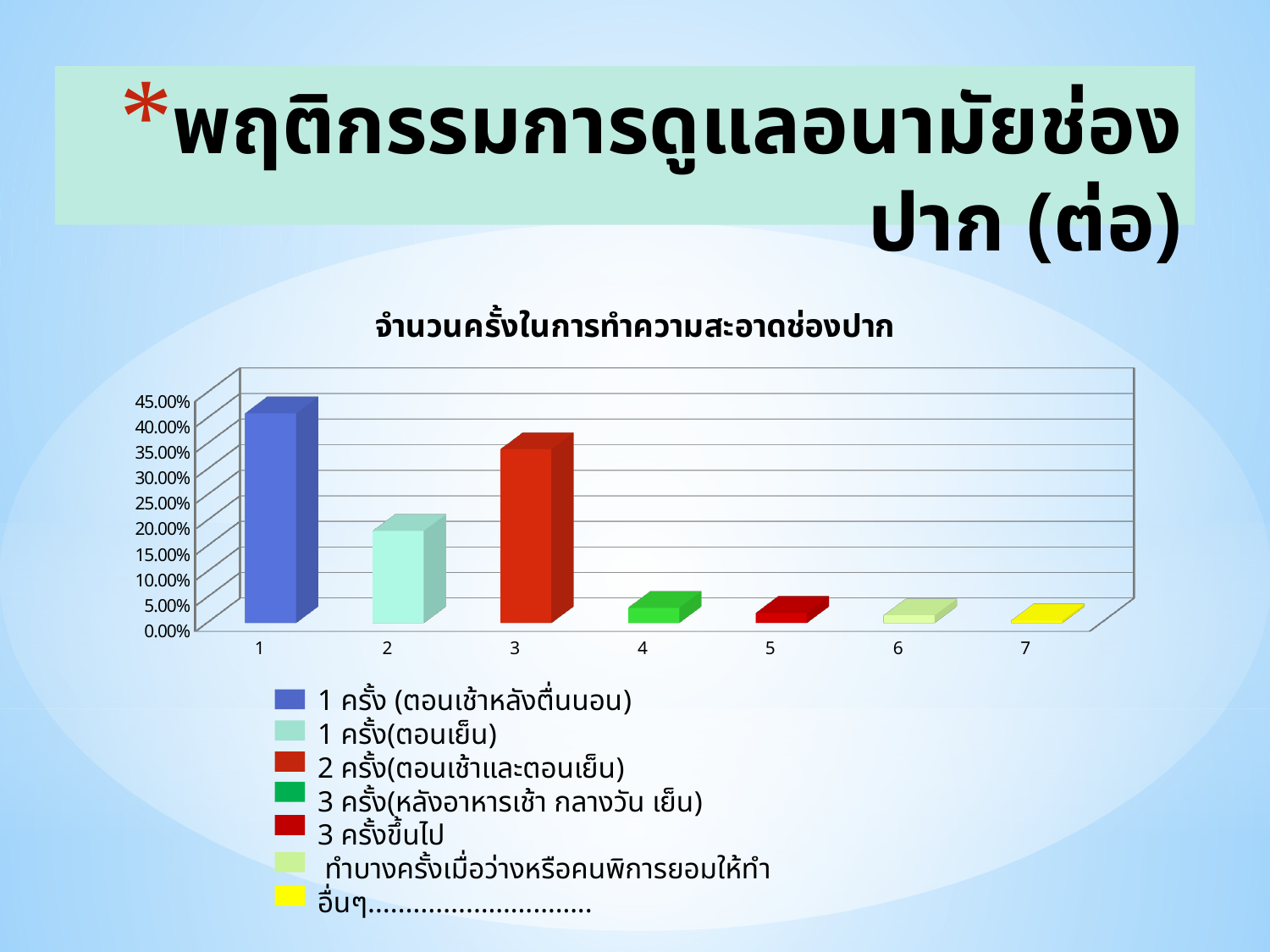
Is the value for category 2 greater or less than 25.00%? less What kind of chart is shown on the slide? bar chart How many entries does the legend list? 7 Which is larger, the value for category 2 or category 3? 3 Is the value for category 1 greater or less than 35.00%? greater Which is larger, the value for category 1 or category 3? 1 Which category has the highest bar? 1 Is the value for category 3 greater or less than 30.00%? greater How many categories are plotted along the x axis? 7 What is the title of the chart? จำนวนครั้งในการทำความสะอาดช่องปาก What colour is the bar for category 1 (1 ครั้ง (ตอนเช้าหลังตื่นนอน))? blue